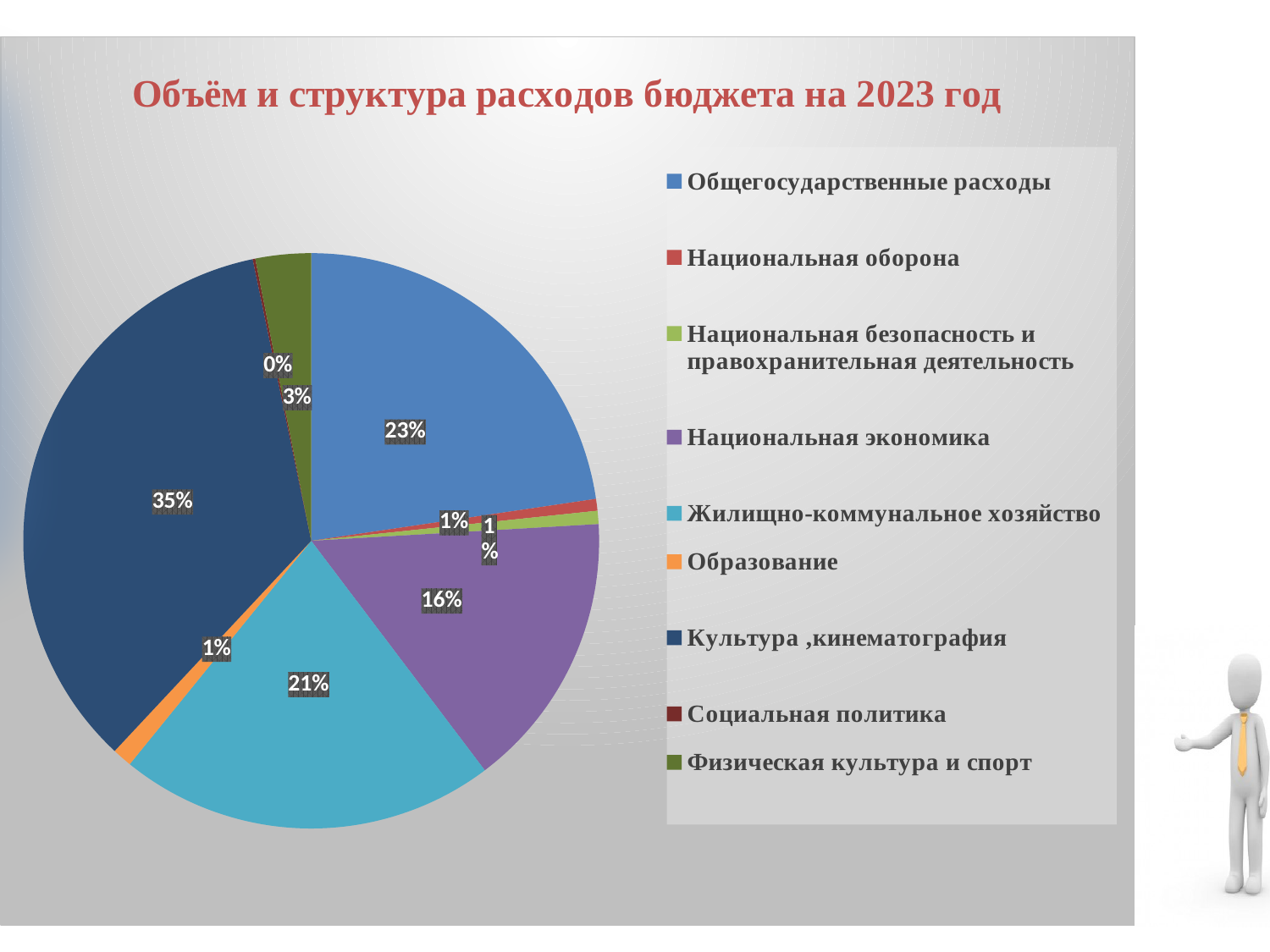
What share of the pie is Культура ,кинематография? 35% What is the title of the chart? Объём и структура расходов бюджета на 2023 год What share of the pie is Жилищно-коммунальное хозяйство? 21% What is the difference between the share for Культура ,кинематография and the share for Общегосударственные расходы? 12% What share of the pie is Национальная экономика? 16% How many categories does the legend list? 9 Which is larger, the share for Жилищно-коммунальное хозяйство or the share for Национальная экономика? Жилищно-коммунальное хозяйство What type of chart is shown on the slide? pie chart Which category has the largest share of the pie? Культура ,кинематография